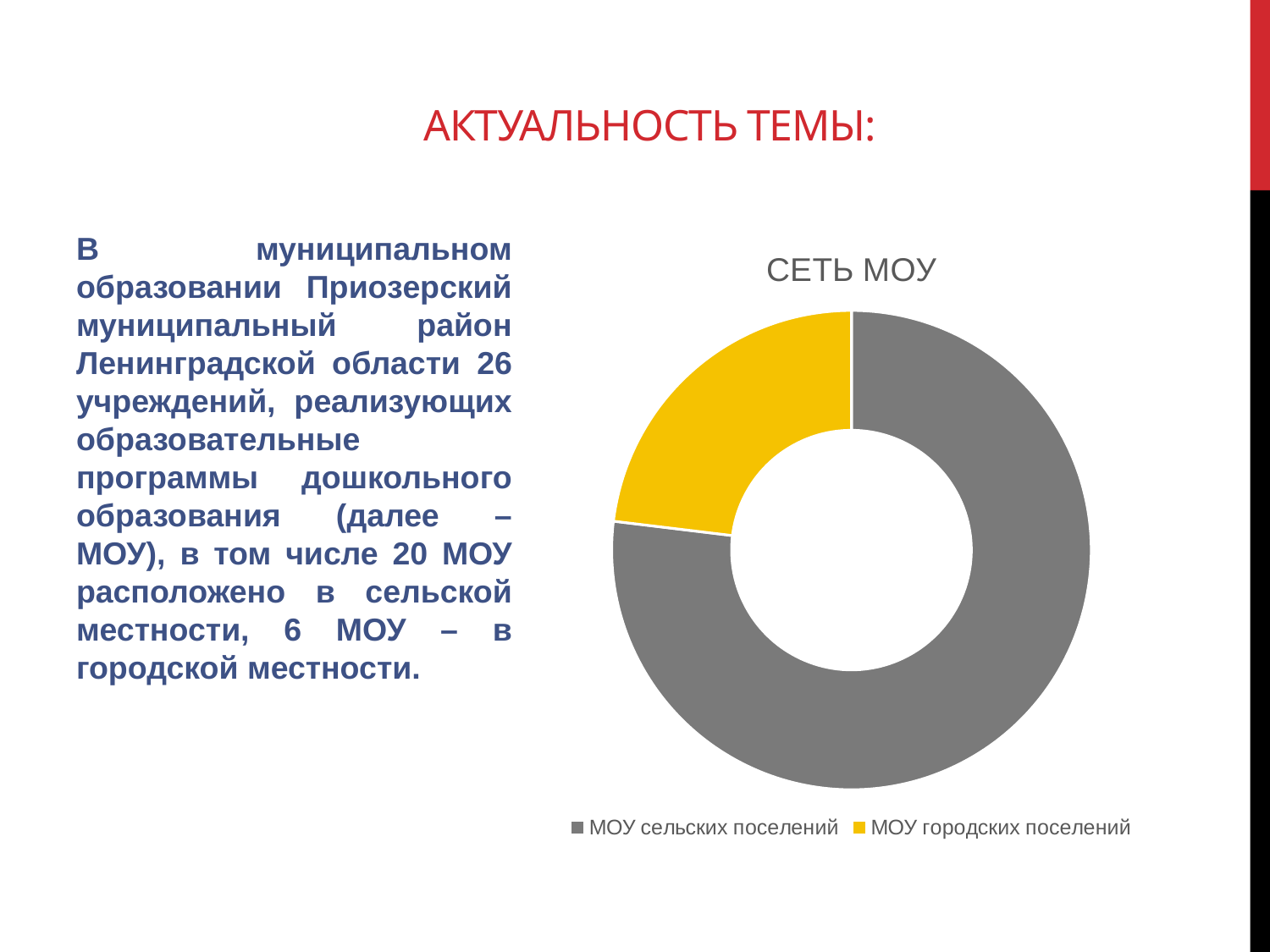
Which category has the largest share of the chart? МОУ сельских поселений How many entries does the chart legend list? 2 Which is larger: the share for МОУ сельских поселений or for МОУ городских поселений? МОУ сельских поселений What is the title of the chart on the slide? СЕТЬ МОУ What colour represents МОУ городских поселений in the chart? yellow Which category has the smallest share of the chart? МОУ городских поселений What kind of chart is shown on the slide? doughnut chart How many categories does the chart show? 2